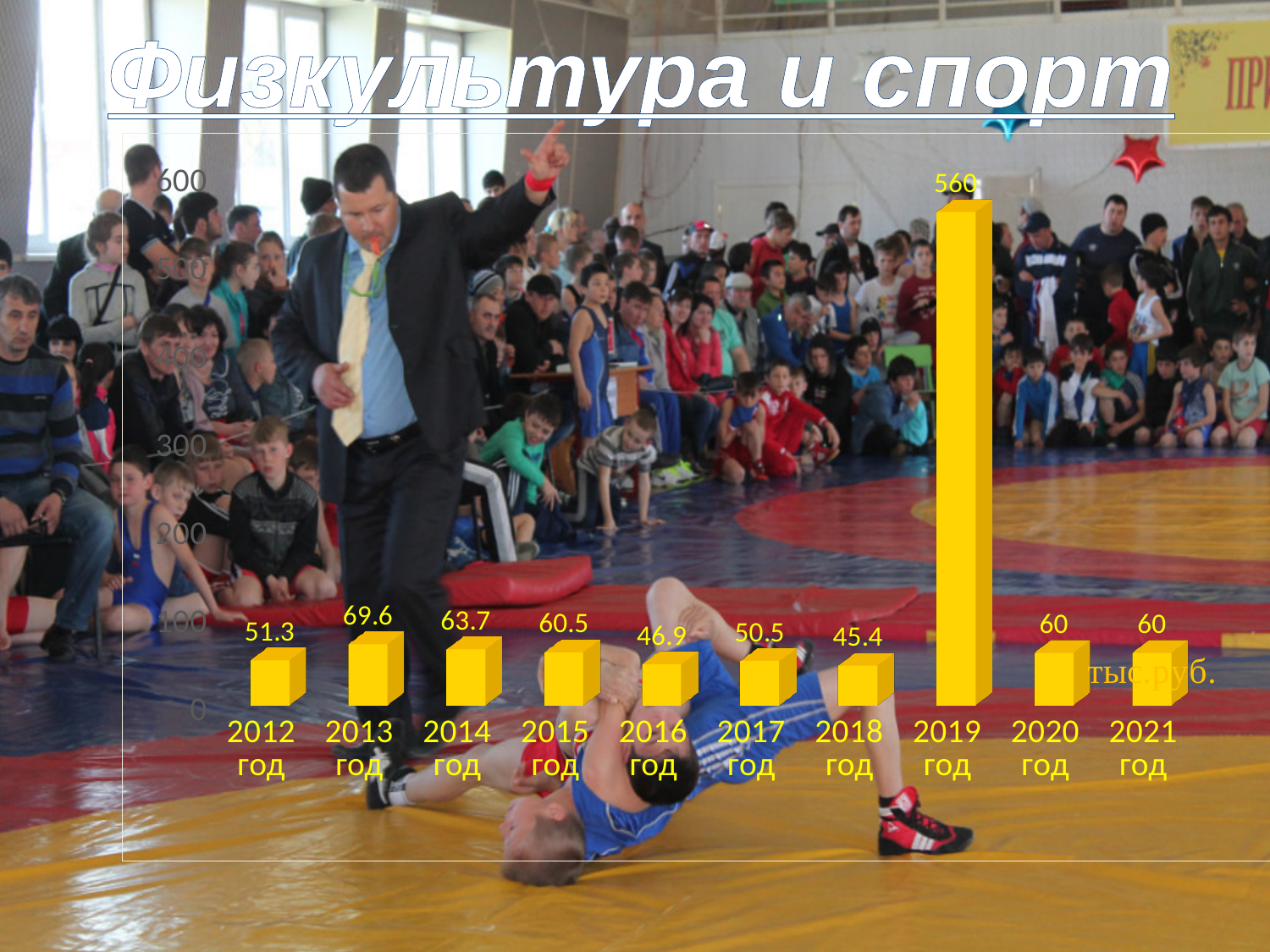
Which is larger, the value for 2012 год or the value for 2017 год? 2012 год Which year has the highest value? 2019 год What is the value for 2013 год? 69.6 What is the value for 2016 год? 46.9 Is the value for 2019 год greater or less than 500? greater What kind of chart is shown on the slide? bar chart What unit label is shown next to the chart? тыс.руб. Which year has the lowest value? 2018 год How many years are shown on the x axis? 10 What is the difference between the values for 2013 год and 2014 год? 5.9 What is the value for 2019 год? 560 What is the value for 2018 год? 45.4